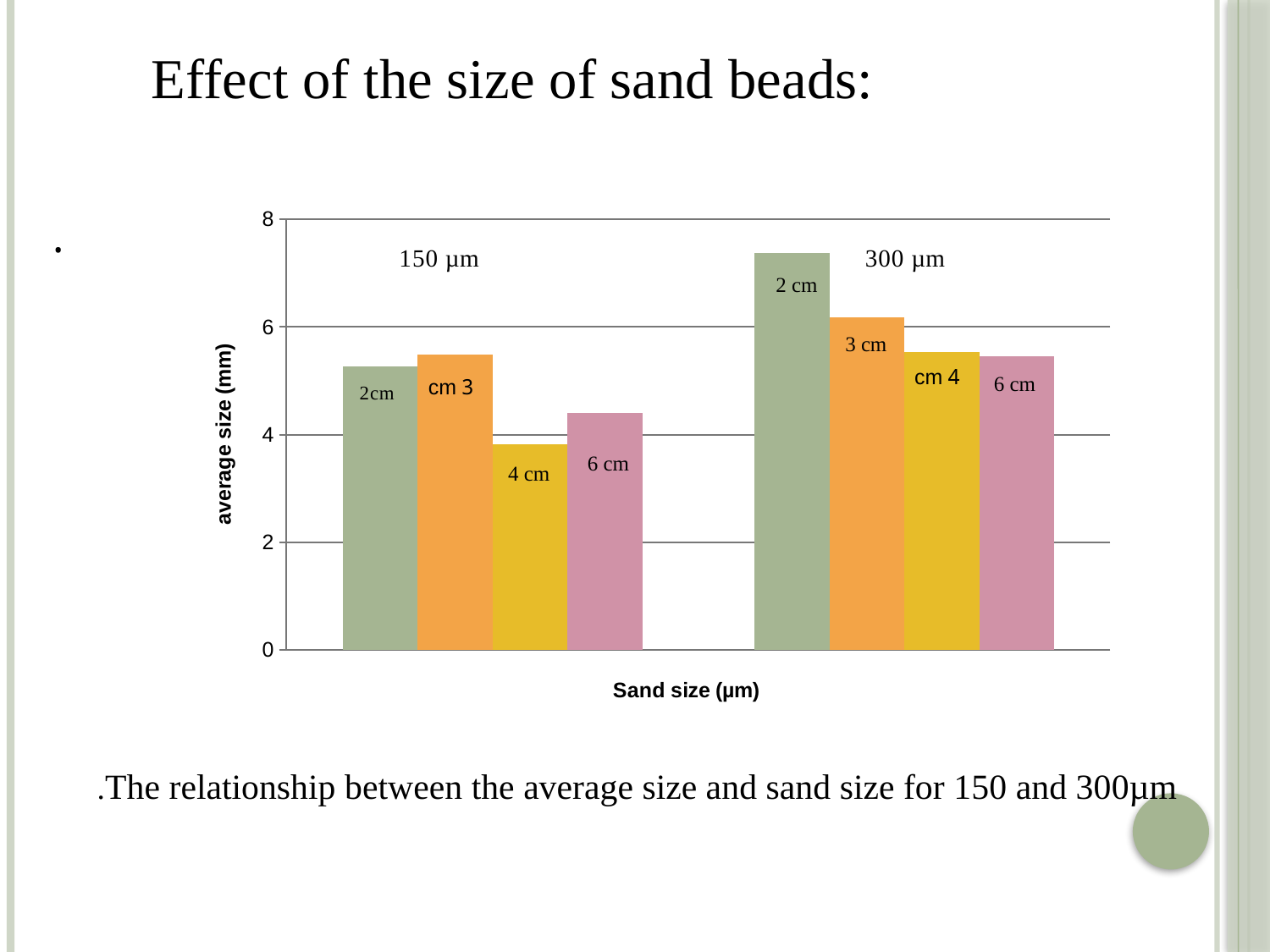
What is the label of the y axis of the chart? average size (mm) Is the value for 6 cm in the 150 μm group greater or less than 4? greater Which is larger: the 2 cm bar in the 150 μm group or the 2 cm bar in the 300 μm group? 2 cm in the 300 μm group Is the value for 4 cm in the 300 μm group greater or less than 6? less Is the value for 2 cm in the 300 μm group greater or less than 6? greater In the 300 μm group, do the bars rise or fall from 2 cm to 6 cm? fall Which bar is the shortest in the chart? 4 cm in the 150 μm group How many sand-size groups are shown on the x axis of the chart? 2 How many bars are plotted in the chart in total? 8 Which bar is the tallest in the chart? 2 cm in the 300 μm group What kind of chart is shown on the slide? bar chart Which is larger in the 150 μm group: the 4 cm bar or the 6 cm bar? 6 cm